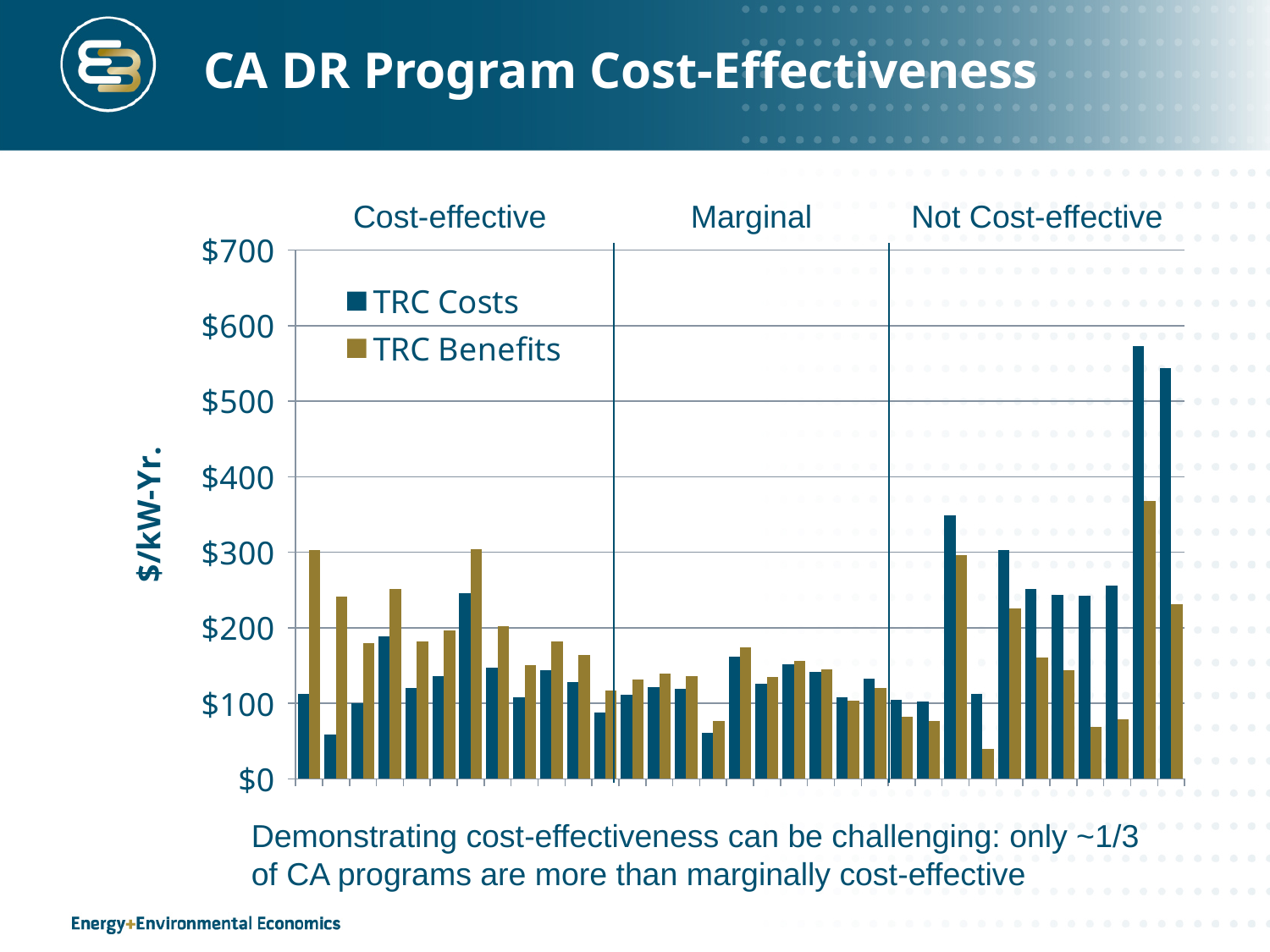
What kind of chart is shown on the slide? bar chart Is the value of the tallest TRC Costs bar greater or less than $500? greater Does any bar on the chart exceed $600? No What are the two series named in the chart's legend? TRC Costs and TRC Benefits What is the label on the chart's vertical axis? $/kW-Yr. Which section of the chart contains the tallest bar? Not Cost-effective Which series does the tallest bar on the chart belong to? TRC Costs Is the value of the tallest TRC Benefits bar greater or less than $400? less How many labelled sections is the chart divided into along the x axis? 3 How many series does the chart's legend list? 2 What is the highest value shown on the chart's vertical axis? $700